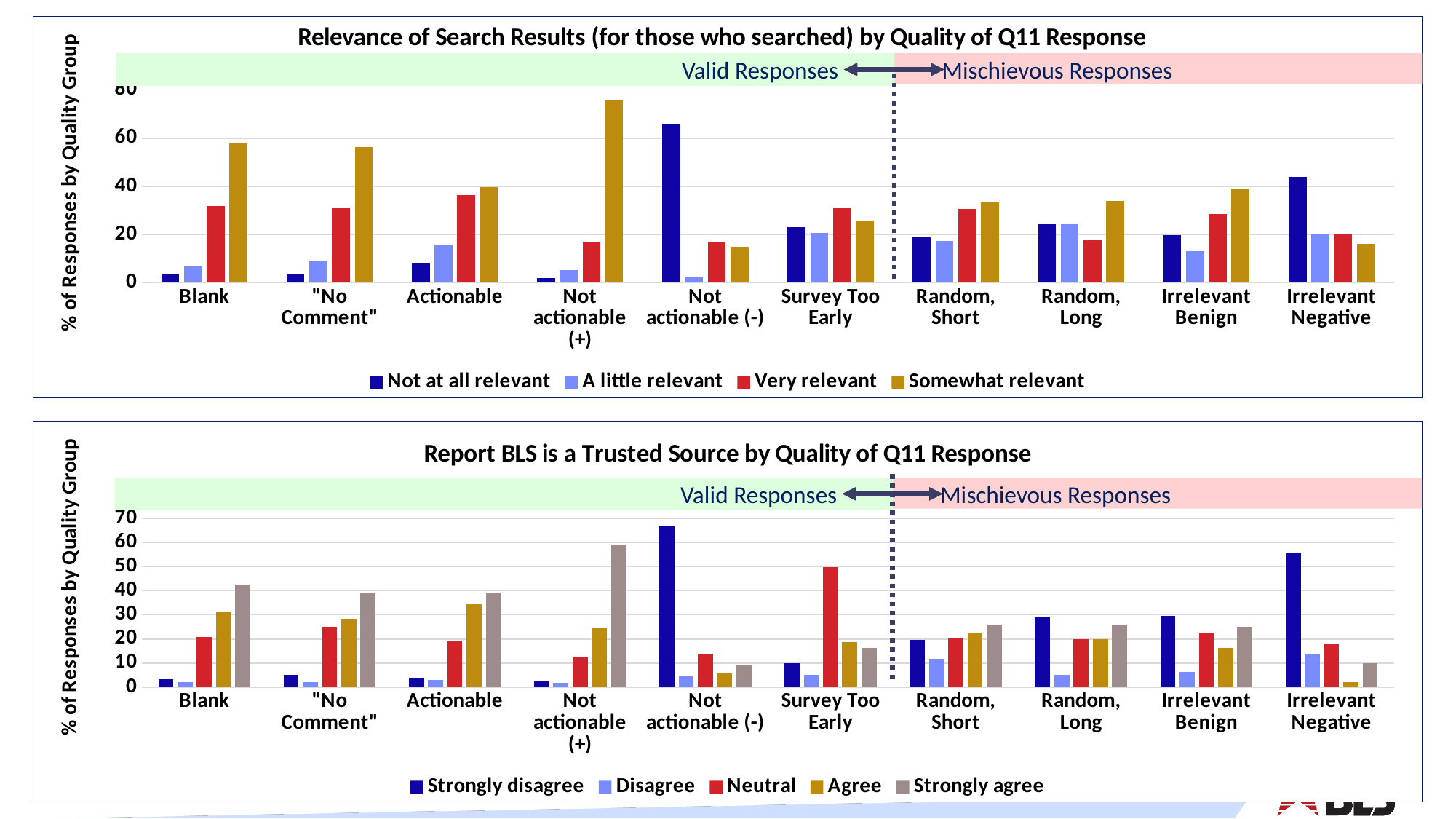
How many categories are shown on the x axis of the bottom chart? 10 In the top chart, for 'Blank', which is larger: 'Very relevant' or 'Somewhat relevant'? Somewhat relevant In the bottom chart, which category has the highest 'Strongly disagree' bar? Not actionable (-) In the top chart, which category has the highest 'Somewhat relevant' bar? Not actionable (+) In the bottom chart, for 'Irrelevant Negative', which is larger: 'Strongly disagree' or 'Strongly agree'? Strongly disagree How many series does the legend of the bottom chart, 'Report BLS is a Trusted Source by Quality of Q11 Response', list? 5 In the bottom chart, which category has the lowest 'Agree' bar? Irrelevant Negative In the top chart, is the 'Not at all relevant' value for 'Not actionable (-)' greater or less than 60? greater In the bottom chart, is the 'Strongly disagree' value for 'Not actionable (-)' greater or less than 60? greater In the top chart, is the 'Somewhat relevant' value for 'Not actionable (+)' greater or less than 60? greater How many series does the legend of the top chart list? 4 What kind of chart is the top chart, 'Relevance of Search Results (for those who searched) by Quality of Q11 Response'? Bar chart